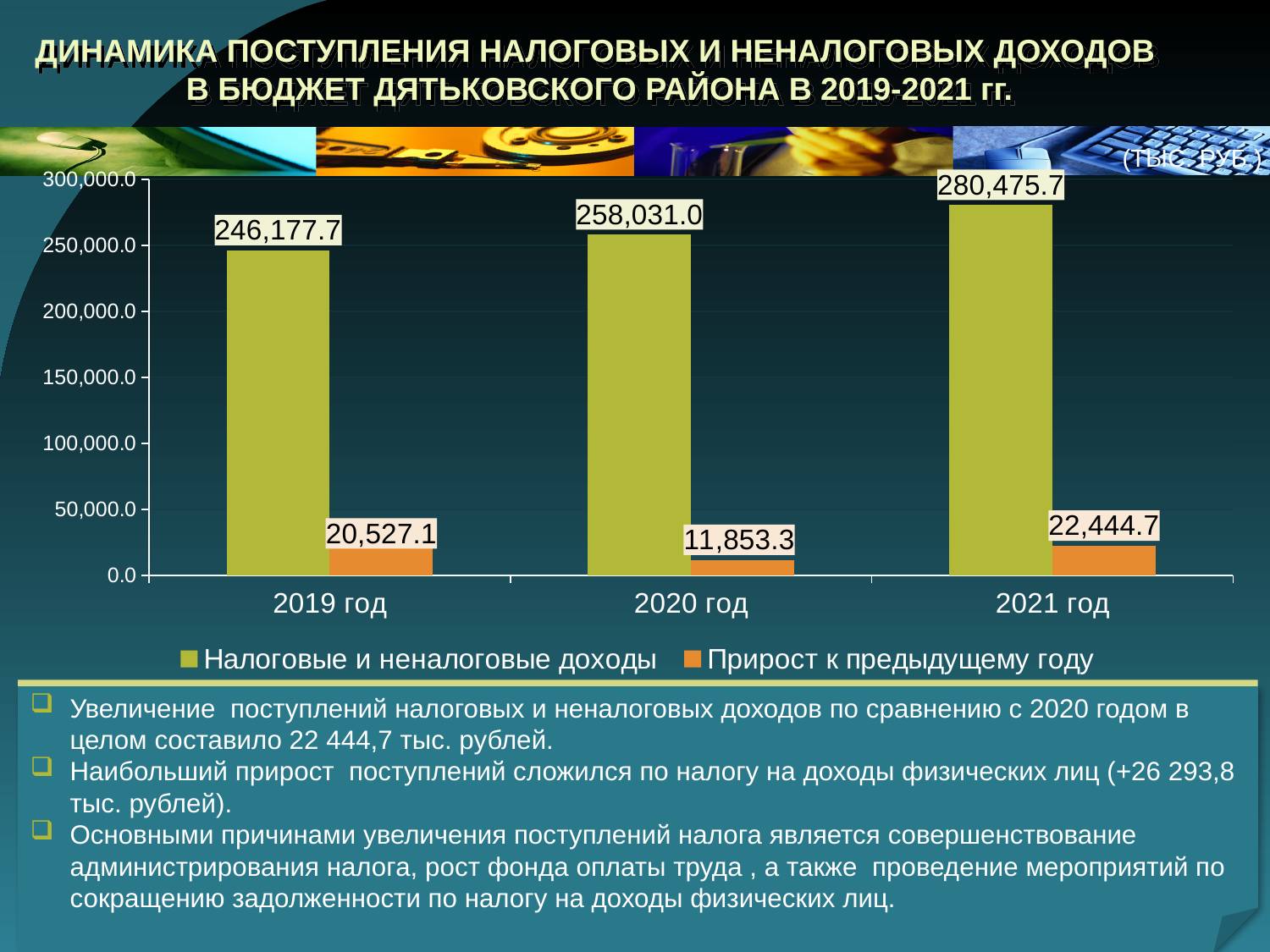
Do the values for 'Налоговые и неналоговые доходы' rise or fall from 2019 год to 2021 год? rise Which year has the highest value for 'Налоговые и неналоговые доходы'? 2021 год Is the value for 'Налоговые и неналоговые доходы' in 2019 год greater or less than 250,000.0? less What is the value of 'Прирост к предыдущему году' for 2019 год? 20,527.1 Which is larger: 'Прирост к предыдущему году' in 2019 год or in 2021 год? 2021 год Which year has the lowest value for 'Прирост к предыдущему году'? 2020 год What kind of chart is shown on the slide? bar chart How many years are shown on the x axis? 3 What is the difference between 'Налоговые и неналоговые доходы' in 2021 год and 2020 год? 22,444.7 What is the value of 'Налоговые и неналоговые доходы' for 2021 год? 280,475.7 How many series does the legend list? 2 What is the value of 'Налоговые и неналоговые доходы' for 2020 год? 258,031.0